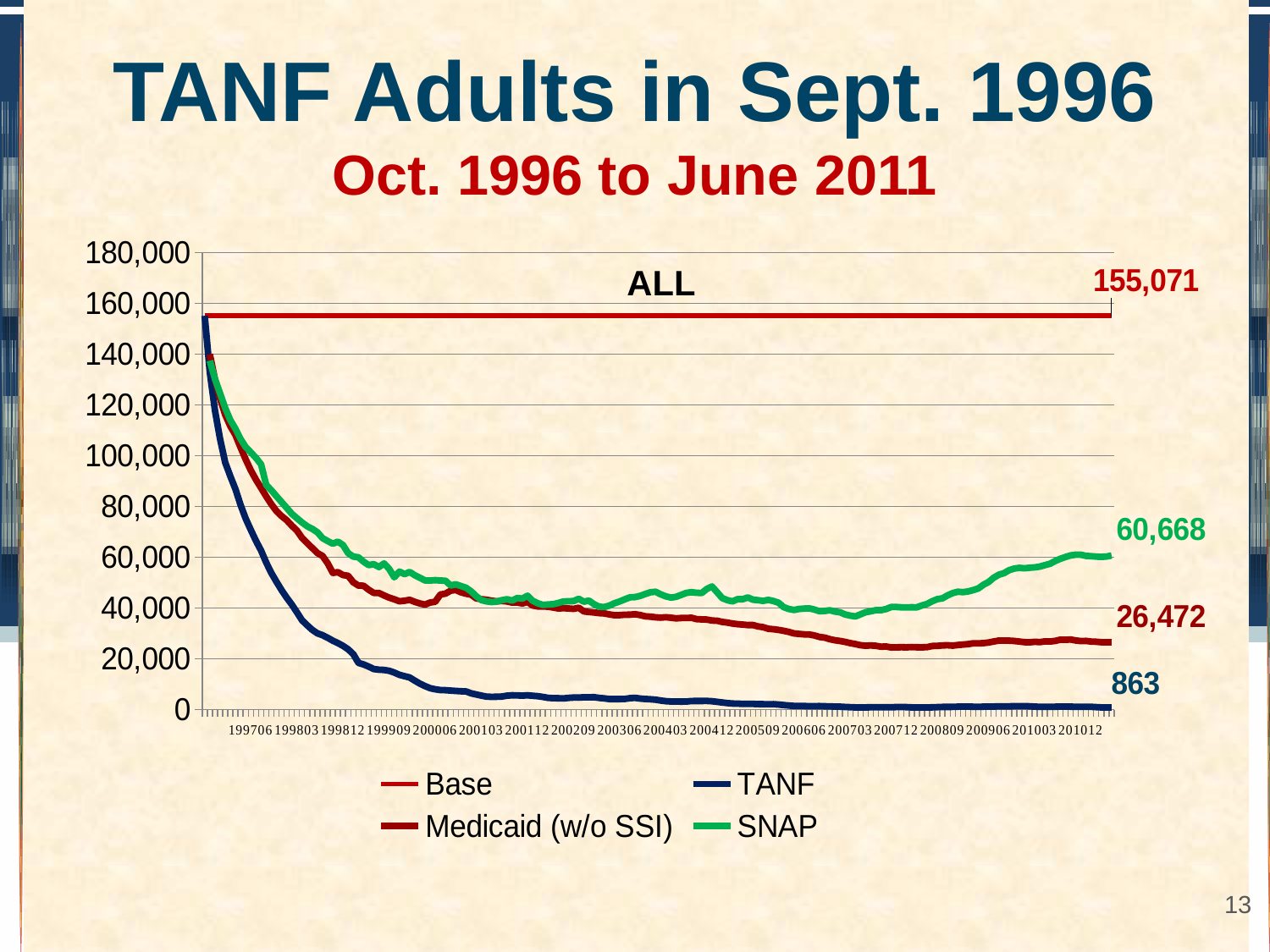
What is the difference between the Base value of 155,071 and the final TANF value of 863? 154,208 Which series has the lowest value at the end of the period? TANF What is the final value shown for the TANF series? 863 What kind of chart is shown on the slide? Line chart Does the TANF series rise or fall over the period shown? Fall What is the final value shown for the Medicaid (w/o SSI) series? 26,472 What is the difference between the final SNAP value and the final Medicaid (w/o SSI) value? 34,196 What is the final value shown for the SNAP series? 60,668 Which series has the highest value at the end of the period? Base What value is labelled on the Base line marked ALL? 155,071 At the end of the period, which is larger: the SNAP value or the Medicaid (w/o SSI) value? SNAP How many series does the legend list? 4